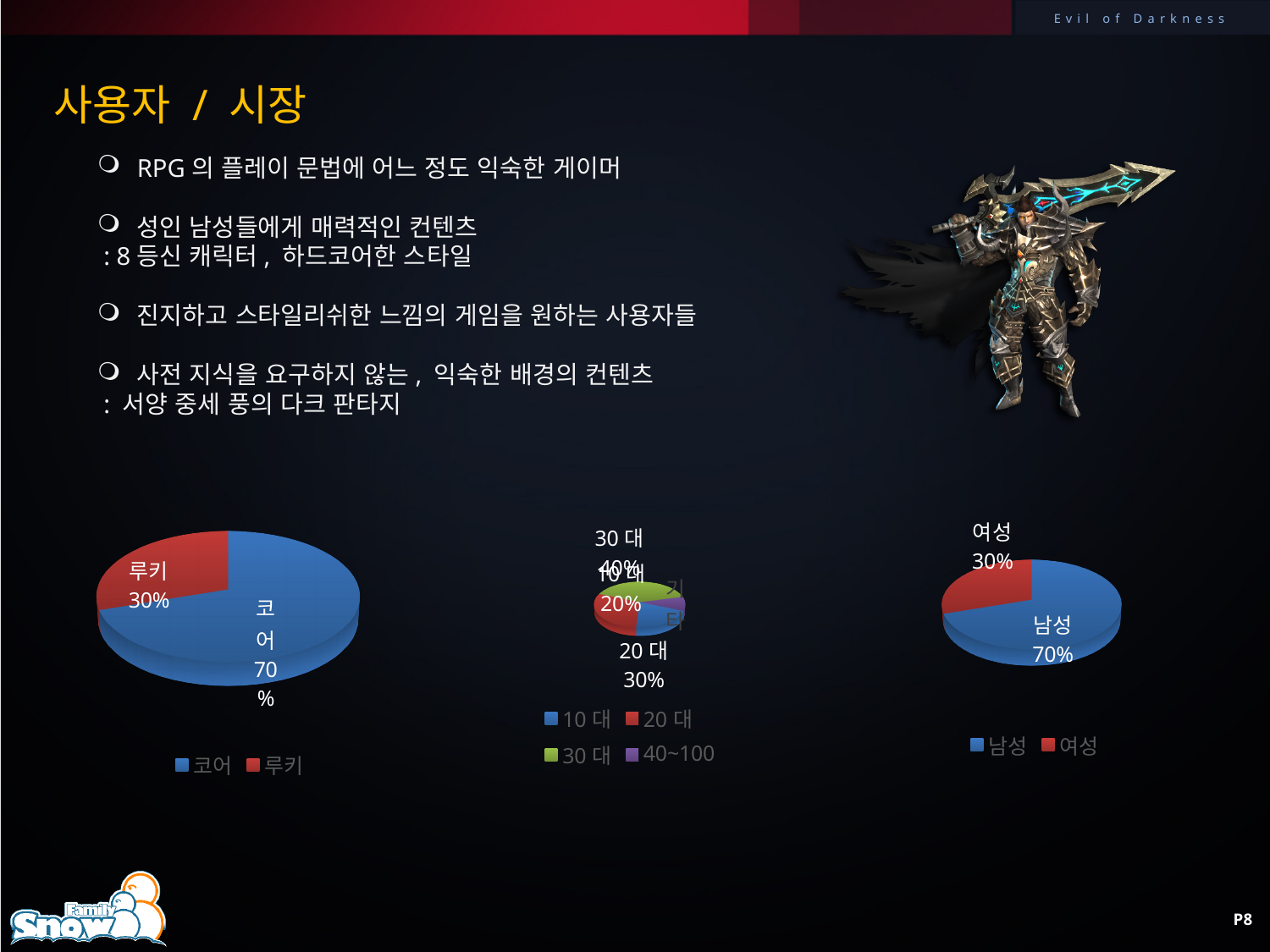
How many entries does the legend of the left pie chart list? 2 What kind of chart is the left chart on the slide? pie chart In the right pie chart, what share does 여성 have? 30% In the left pie chart, what share does 코어 have? 70% In the right pie chart, what share does 남성 have? 70% In the left pie chart, what is the difference between the 코어 and 루키 shares? 40% In the left pie chart, which slice is larger, 코어 or 루키? 코어 In the left pie chart, what share does 루키 have? 30% In the middle pie chart, what share does 20 대 have? 30% In the right pie chart, what colour is the 여성 slice? red How many entries does the legend of the middle pie chart list? 4 In the right pie chart, which slice is the largest? 남성